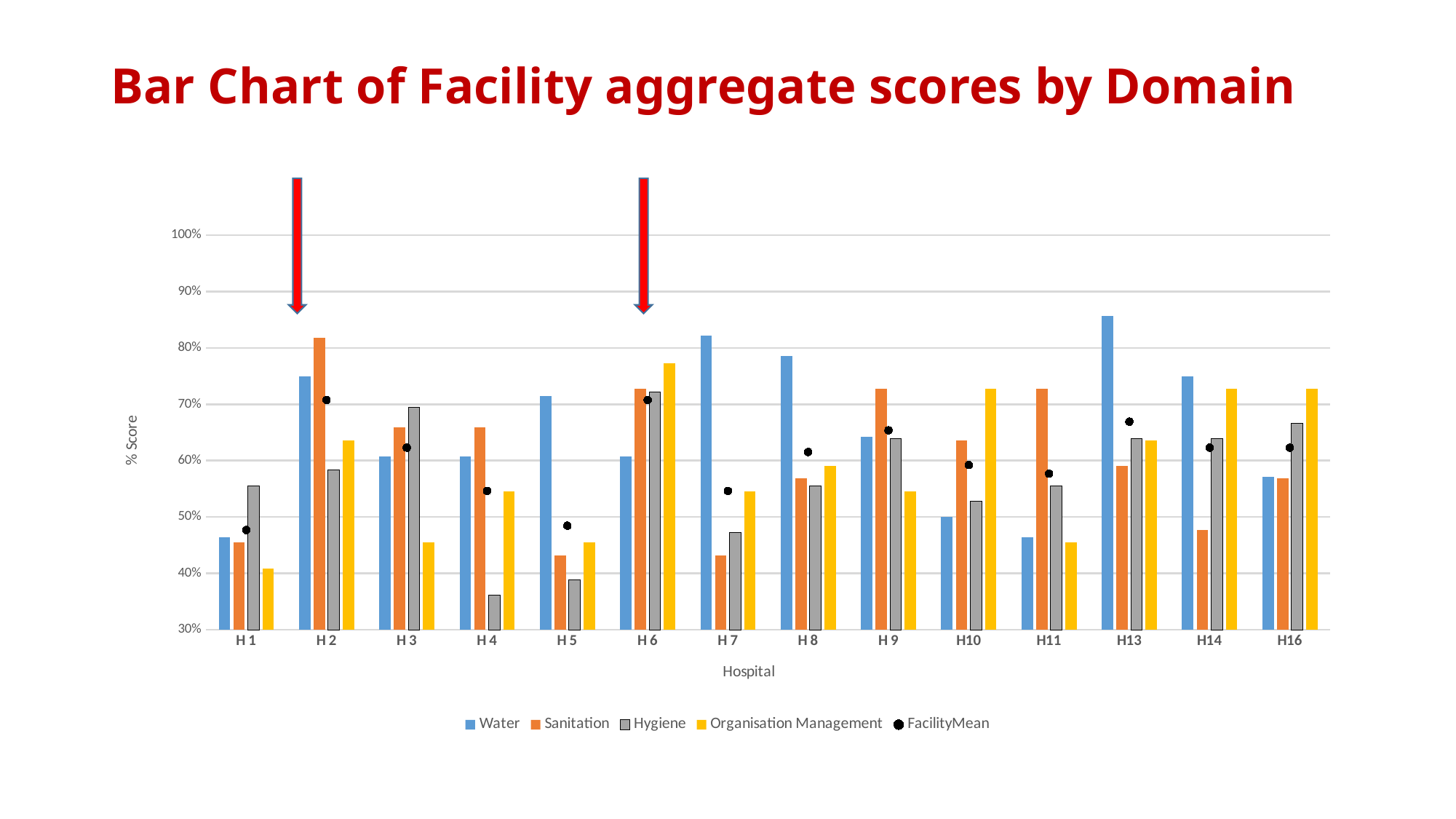
What kind of chart is shown on the slide? Bar chart Which hospital has the lowest Hygiene score? H 4 Which hospital has the lowest Organisation Management score? H 1 Is the Water score for H 7 greater or less than 80%? greater How many hospitals are shown on the x axis of the chart? 14 Is the Hygiene score for H 4 greater or less than 40%? less Which hospital has the highest Water score? H13 Which two hospitals are marked with red arrows above the chart? H 2 and H 6 Is the Sanitation score for H 5 greater or less than 50%? less For H 2, which is larger: the Water score or the Sanitation score? Sanitation How many series does the chart legend list? 5 Which hospital has the highest Sanitation score? H 2